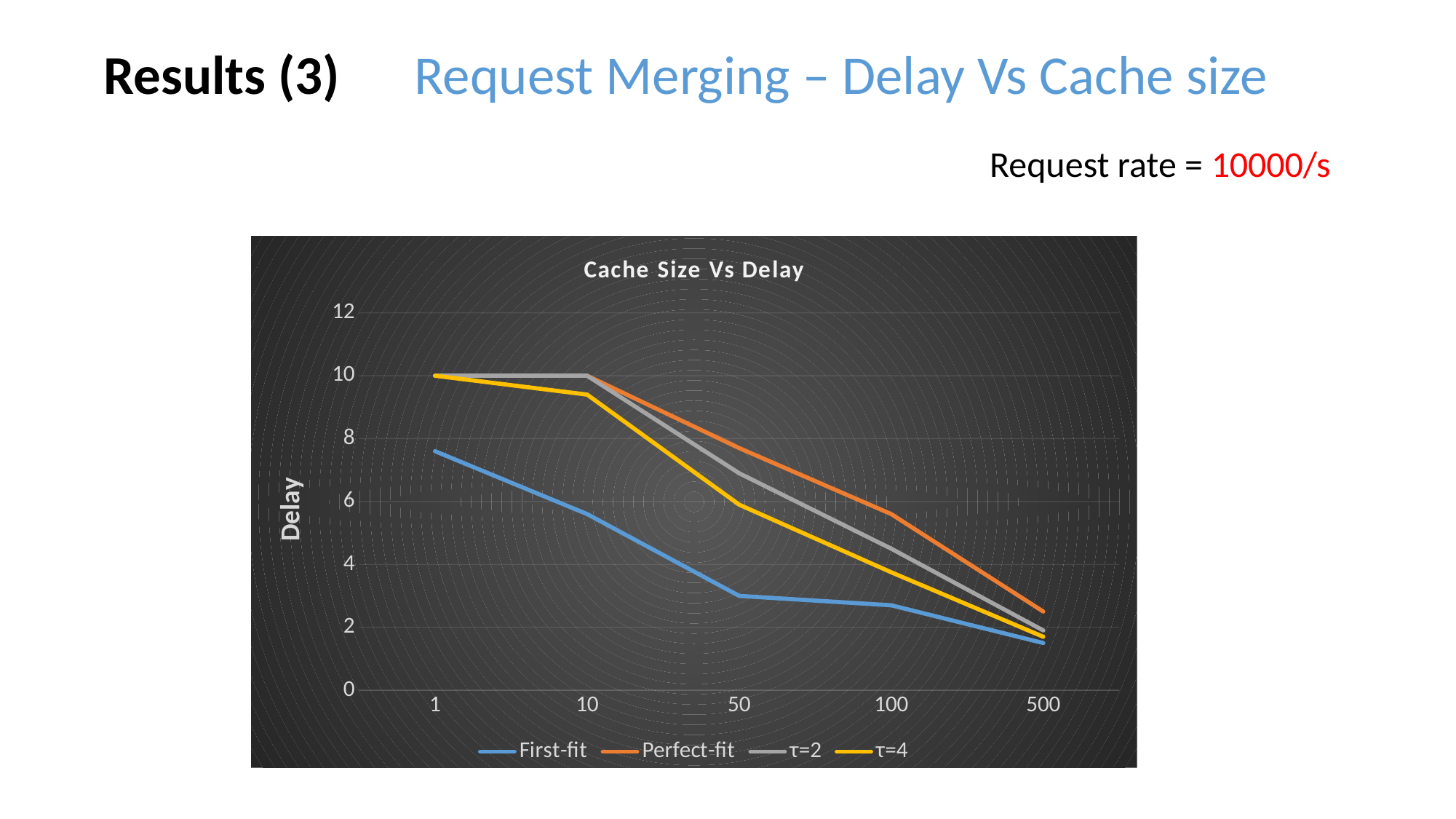
What type of chart is shown on the slide? Line chart Which series has the highest Delay at cache size 500? Perfect-fit What is the Delay for Perfect-fit at cache size 1? 10 What is the Delay for τ=2 at cache size 10? 10 Is the Delay for Perfect-fit at cache size 500 greater or less than 2? greater How many cache size values are plotted along the x axis? 5 Does the Delay for First-fit rise or fall as cache size increases along the x axis? fall Is the Delay for First-fit at cache size 1 greater or less than 8? less Which series has the lowest Delay at cache size 1? First-fit What is the title of the chart? Cache Size Vs Delay At cache size 50, which has the larger Delay: First-fit or Perfect-fit? Perfect-fit How many series does the legend of the Cache Size Vs Delay chart list? 4